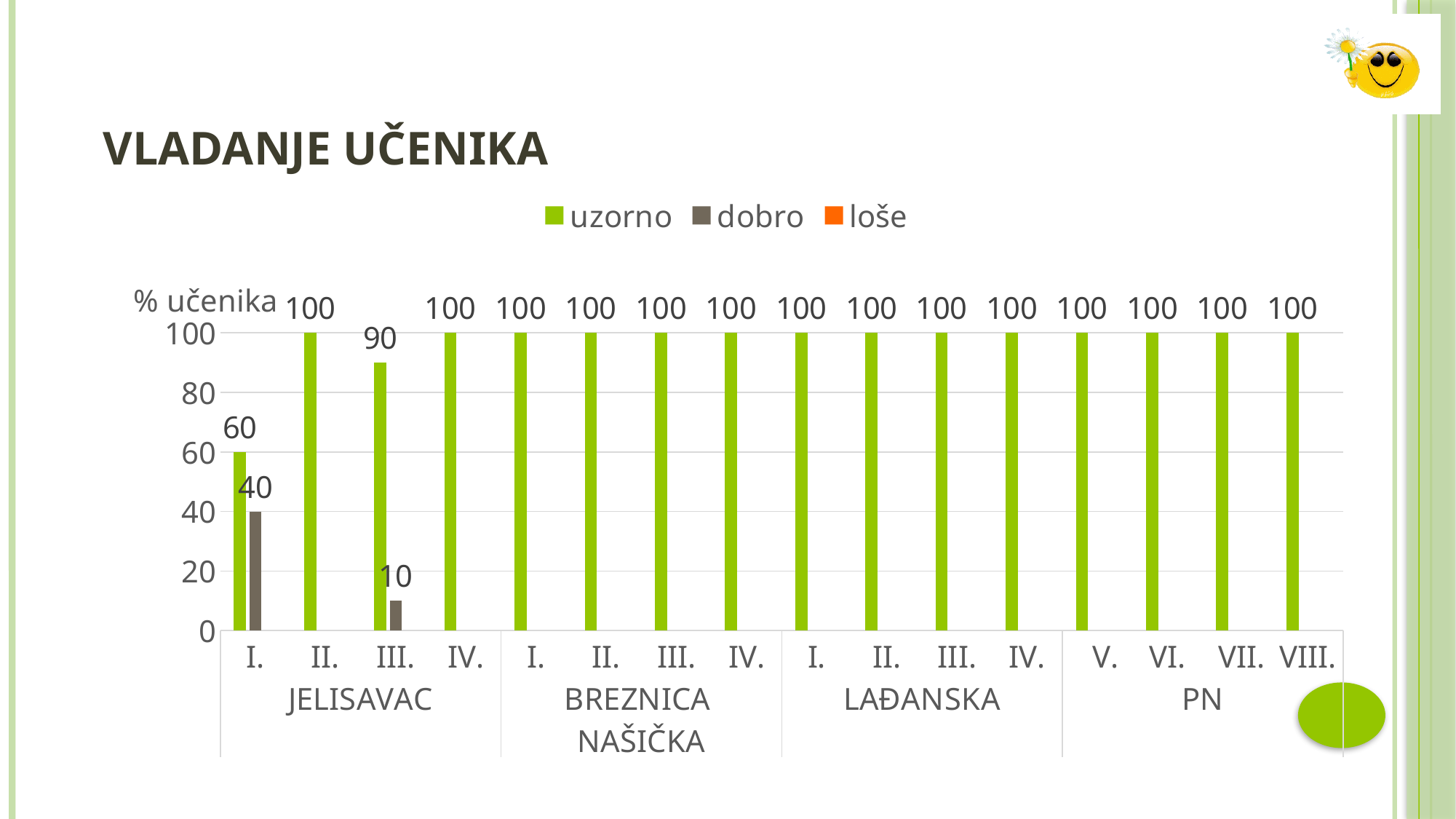
What is the 'dobro' value for class III. in JELISAVAC? 10 Which class has the lowest 'uzorno' value? I. JELISAVAC What is the 'uzorno' value for class III. in JELISAVAC? 90 What is the 'dobro' value for class I. in JELISAVAC? 40 Which is larger for class III. in JELISAVAC, the 'uzorno' value or the 'dobro' value? uzorno What is the 'uzorno' value for class I. in JELISAVAC? 60 What is the 'uzorno' value for class II. in LAĐANSKA? 100 How many classes (categories) are shown on the x axis? 16 How many series does the legend list? 3 What is the title of the slide containing the chart? VLADANJE UČENIKA What is the difference between the 'uzorno' and 'dobro' values for class I. in JELISAVAC? 20 What type of chart is shown on the slide? bar chart